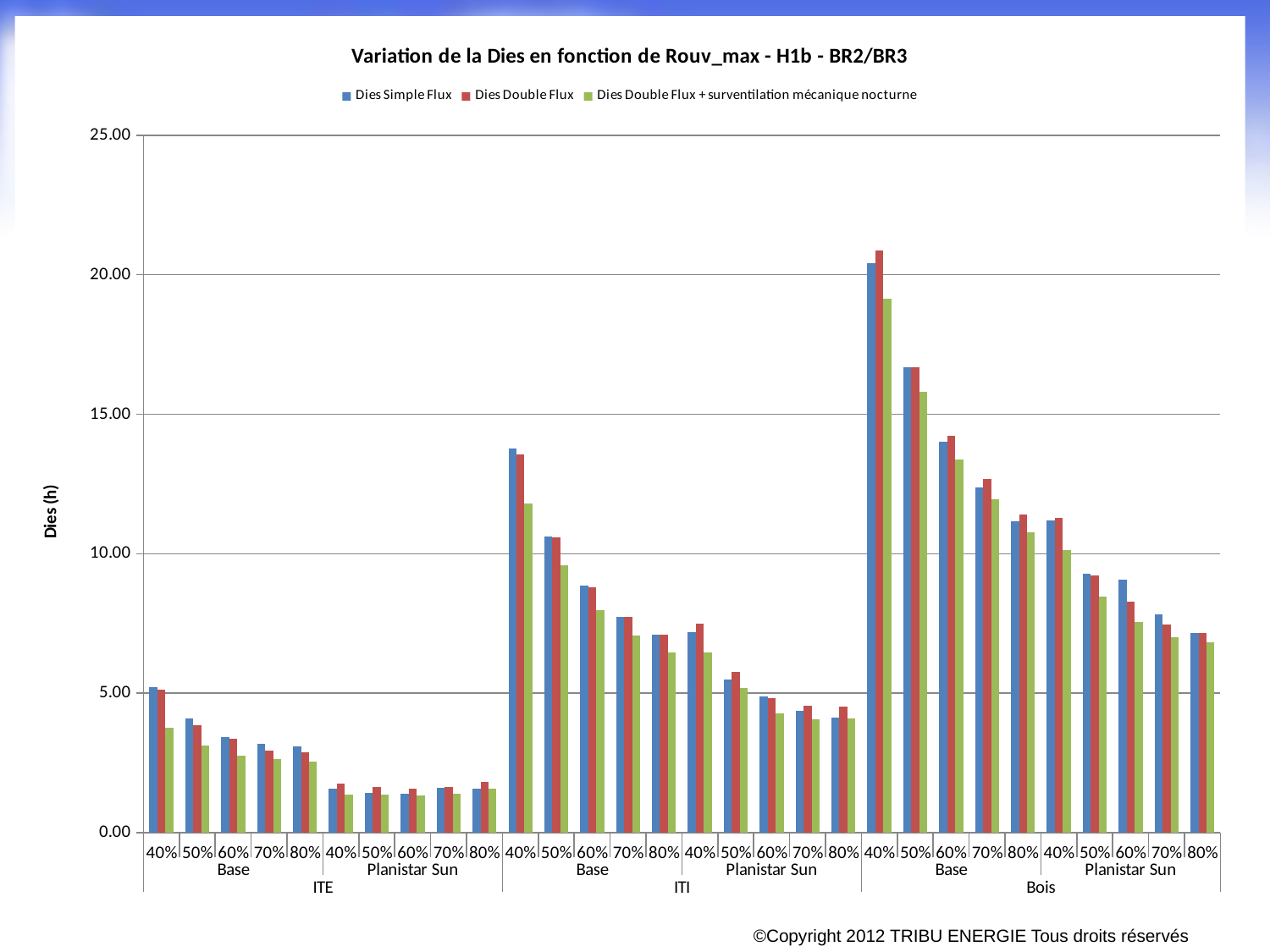
Which is larger: Dies Simple Flux for ITE, Base, 40% or Dies Simple Flux for ITI, Base, 40%? ITI, Base, 40% How many series does the legend list? 3 Is the value of Dies Double Flux + surventilation mécanique nocturne for ITE, Base, 40% greater or less than 5.00? less Is the value of Dies Simple Flux for ITI, Base, 40% greater or less than 10.00? greater Within the Bois Base group, do the Dies Simple Flux values rise or fall as Rouv_max goes from 40% to 80%? fall What kind of chart is shown on the slide? bar chart What is the label of the vertical axis? Dies (h) Is the value of Dies Simple Flux for Bois, Base, 40% greater or less than 15.00? greater Which of the three wall groups (ITE, ITI, Bois) has the highest Dies values? Bois What is the title of the chart? Variation de la Dies en fonction de Rouv_max - H1b - BR2/BR3